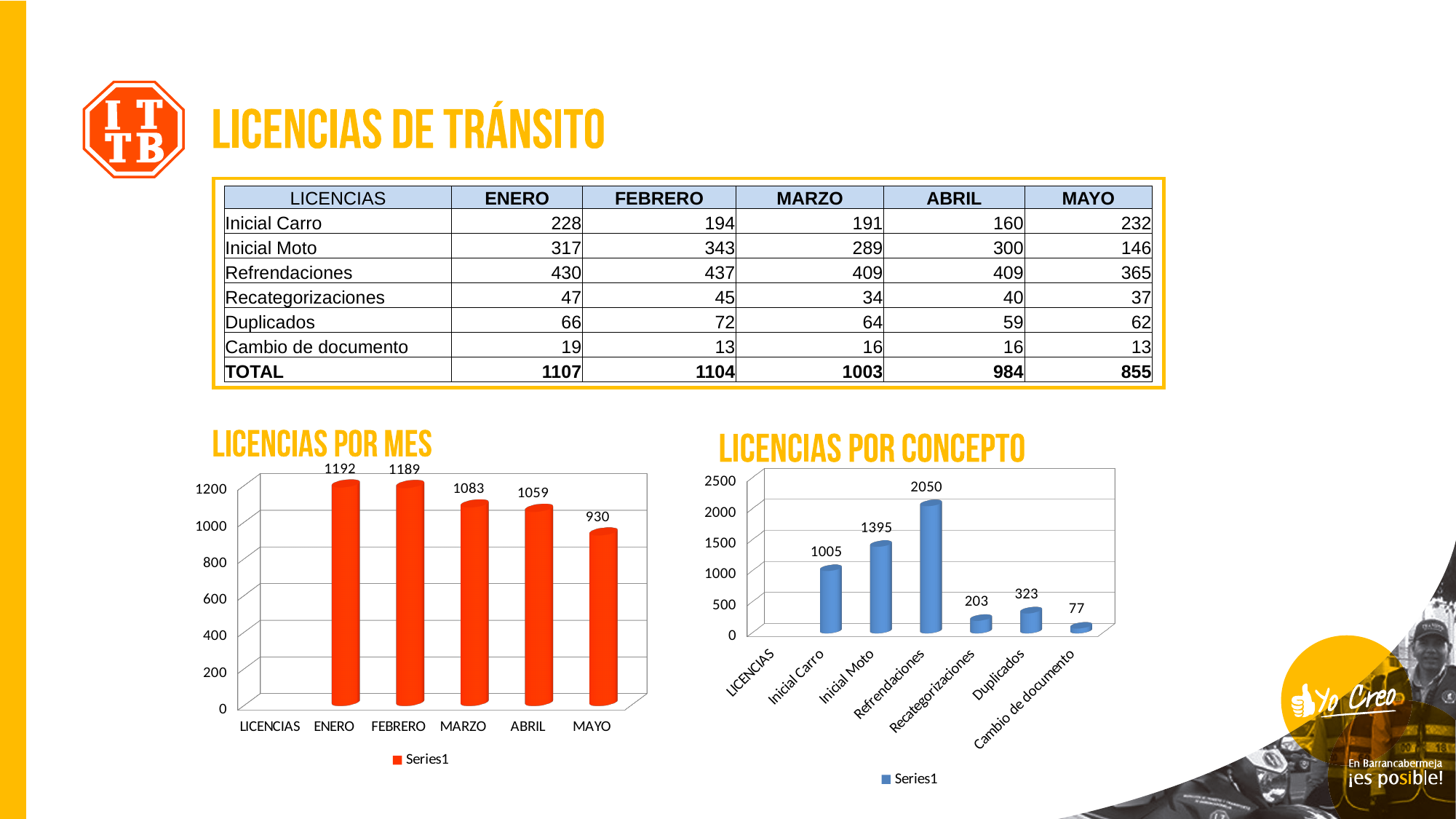
In the LICENCIAS POR CONCEPTO chart, what is the value for Inicial Moto? 1395 In the LICENCIAS POR MES chart, which month has the lowest value? MAYO How many series does the legend of the LICENCIAS POR CONCEPTO chart list? 1 In the LICENCIAS POR CONCEPTO chart, which is larger, Duplicados or Recategorizaciones? Duplicados What kind of chart is the LICENCIAS POR MES chart? bar chart In the LICENCIAS POR CONCEPTO chart, what is the difference between Refrendaciones and Inicial Moto? 655 In the LICENCIAS POR MES chart, what is the value for MARZO? 1083 In the LICENCIAS POR MES chart, do the values rise or fall from ENERO to MAYO? fall In the LICENCIAS POR CONCEPTO chart, which category has the highest value? Refrendaciones In the LICENCIAS POR CONCEPTO chart, which category has the lowest value? Cambio de documento In the LICENCIAS POR MES chart, what is the difference between the values for ENERO and MAYO? 262 How many bars are plotted in the LICENCIAS POR CONCEPTO chart? 6